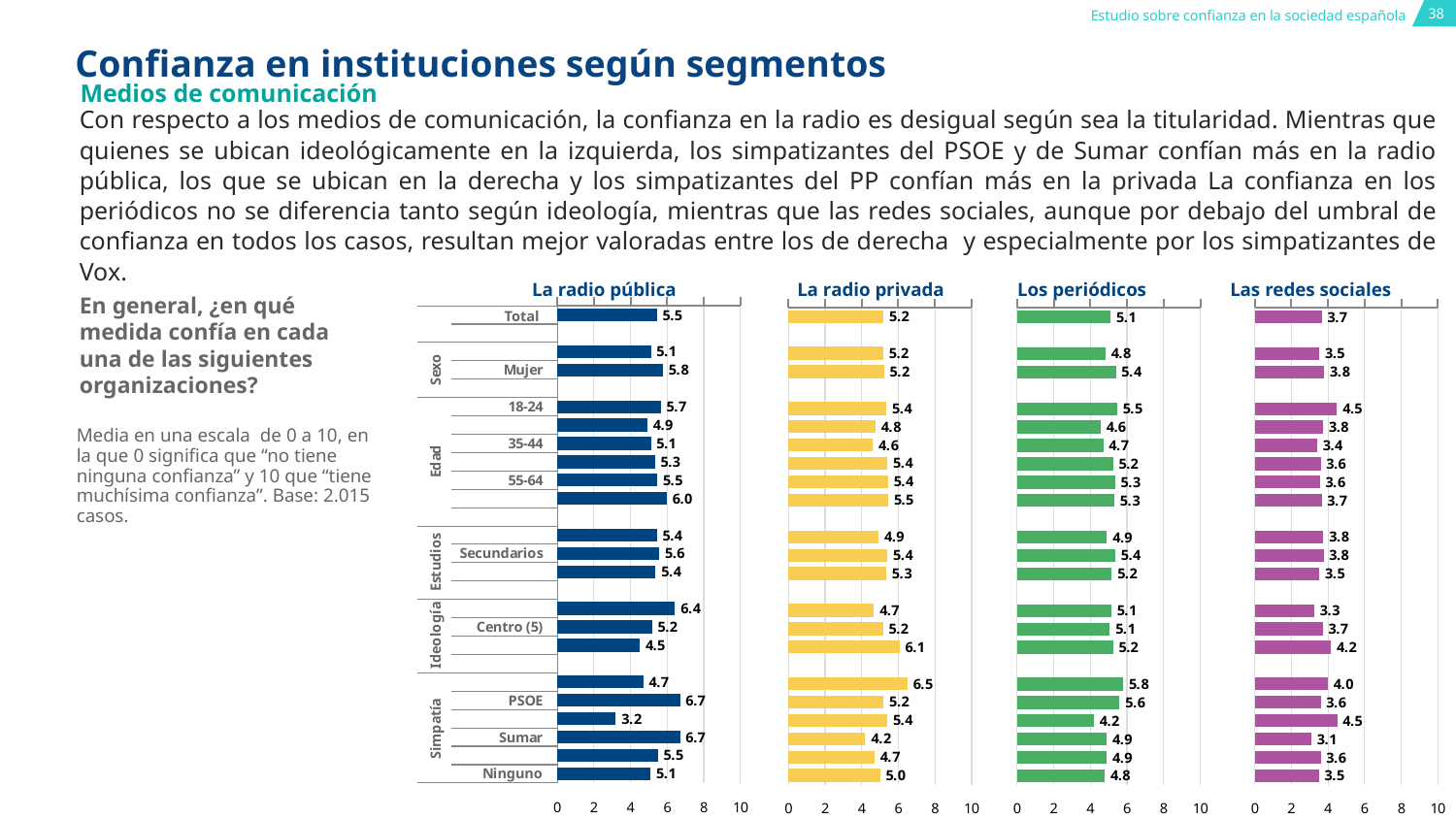
In the 'La radio privada' chart, what is the value for Sumar? 4.2 What type of chart is used for 'La radio privada'? Bar chart In the 'La radio pública' chart, what is the difference between the values for PSOE and Ninguno? 1.6 In the 'Los periódicos' chart, what is the value for Mujer? 5.4 In the 'La radio pública' chart, what is the value for PSOE? 6.7 In the 'Las redes sociales' chart, what is the value for 18-24? 4.5 Which of the four charts shows the lowest value for Total? Las redes sociales How many charts are shown on the slide? 4 In the 'La radio pública' chart, what is the value for Total? 5.5 Which of the four charts shows the highest value for Total? La radio pública In the 'Los periódicos' chart, which is larger, the value for PSOE or the value for Ninguno? PSOE In the 'Las redes sociales' chart, what is the difference between the values for 18-24 and 35-44? 1.1